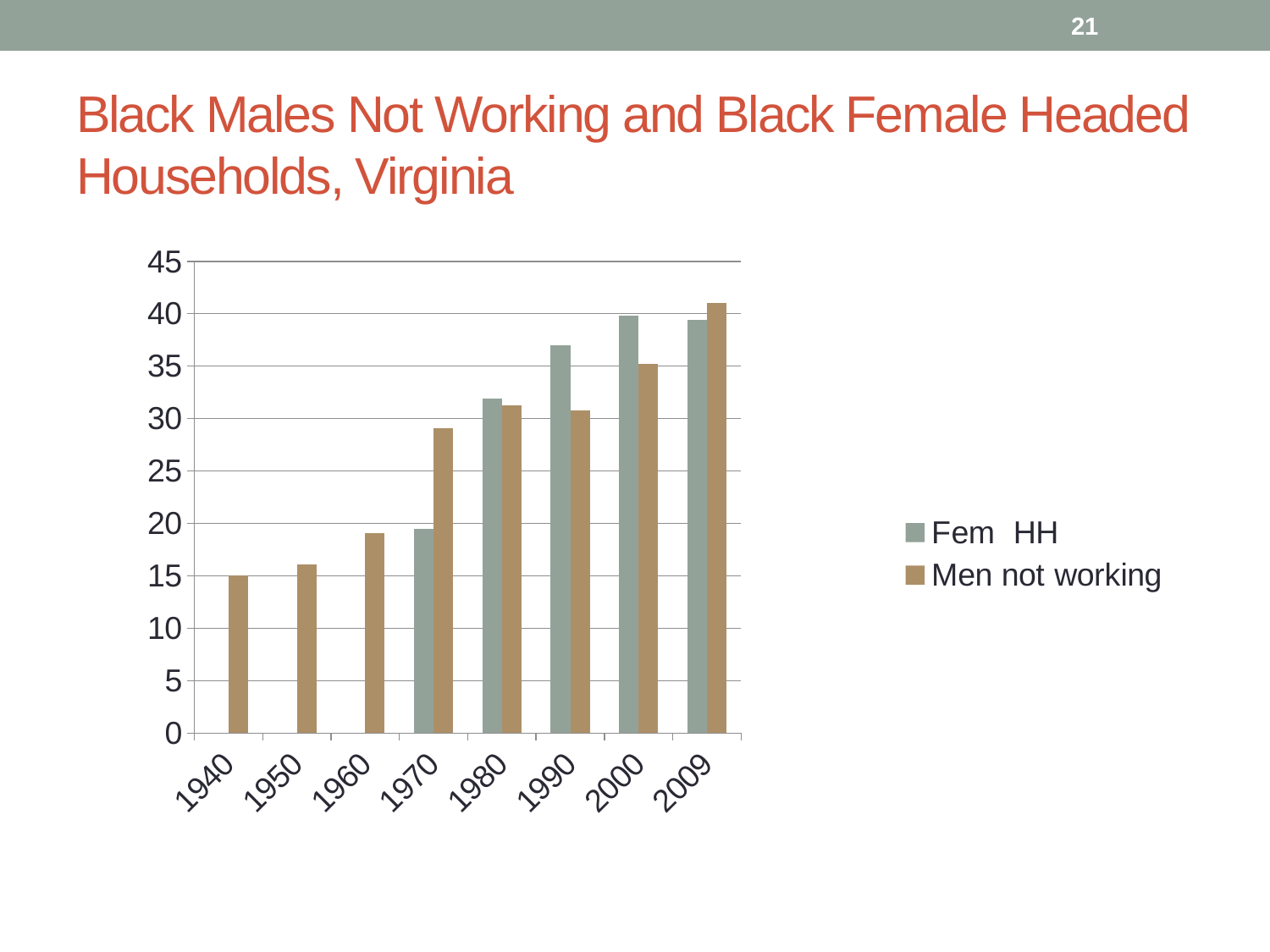
In which year is the Men not working value lowest? 1940 How many years are shown on the x axis? 8 Among the years with a Fem HH bar, which year has the lowest Fem HH value? 1970 Does the Fem HH value rise or fall from 1970 to 2000? rise In how many of the years shown is there a Fem HH bar? 5 In which year is the Men not working value highest? 2009 What kind of chart is shown on the slide? bar chart Is the Men not working value for 1960 greater or less than 20? less In 1970, which is larger: Fem HH or Men not working? Men not working In 2000, which is larger: Fem HH or Men not working? Fem HH Is the Fem HH value for 1990 greater or less than 35? greater How many series does the legend list? 2